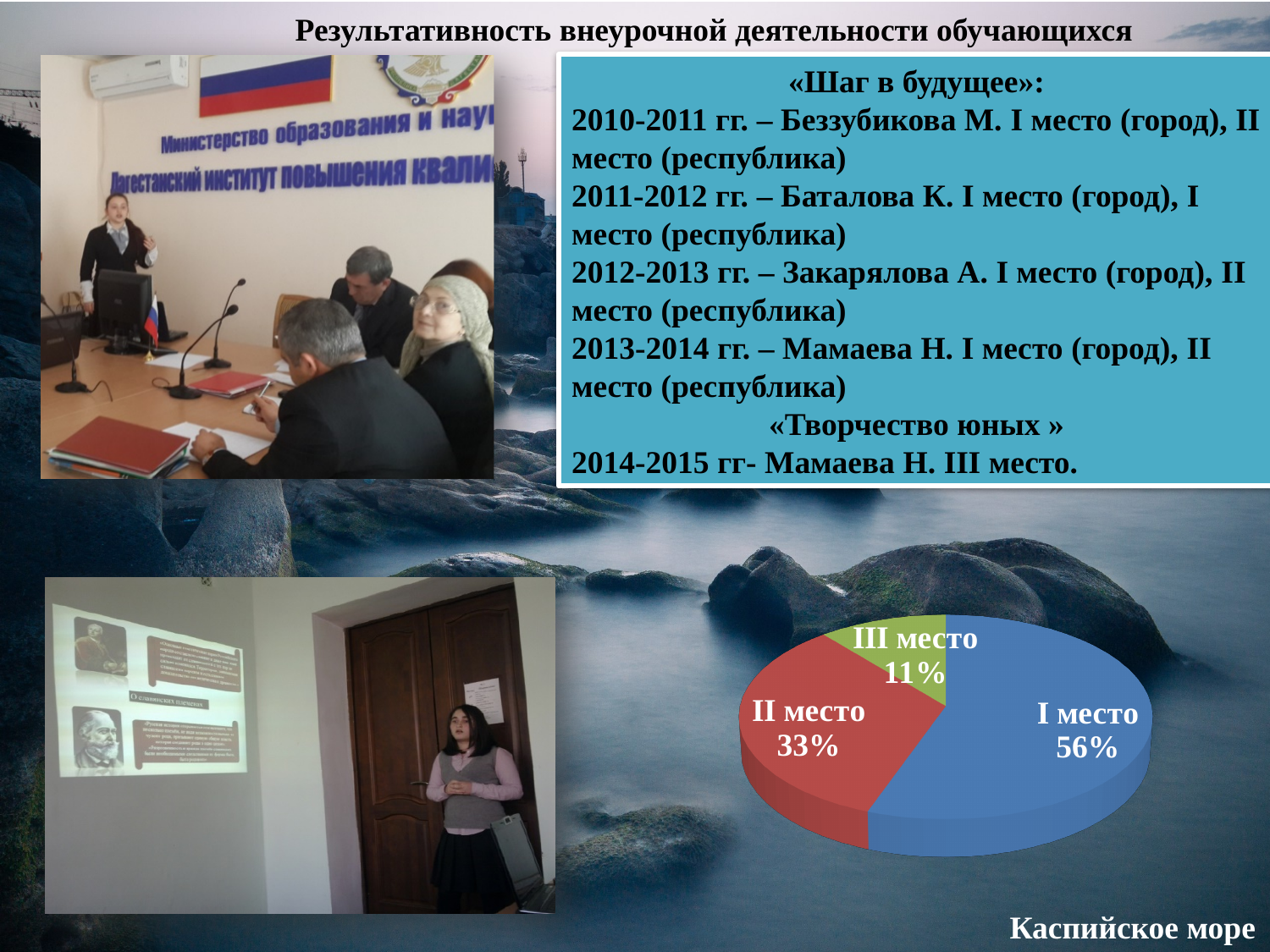
What type of chart is shown on the slide? pie chart How many slices does the pie chart have? 3 Which slice of the pie chart is the smallest? III место What share of the pie does "II место" have? 33% What is the difference in percentage points between "II место" and "III место"? 22% Which is larger in the pie chart, "II место" or "III место"? II место Which slice of the pie chart is the largest? I место What colour is the "I место" slice in the pie chart? blue What share of the pie does "III место" have? 11% What is the difference in percentage points between "I место" and "II место"? 23% What colour is the "II место" slice in the pie chart? red What share of the pie does "I место" have? 56%